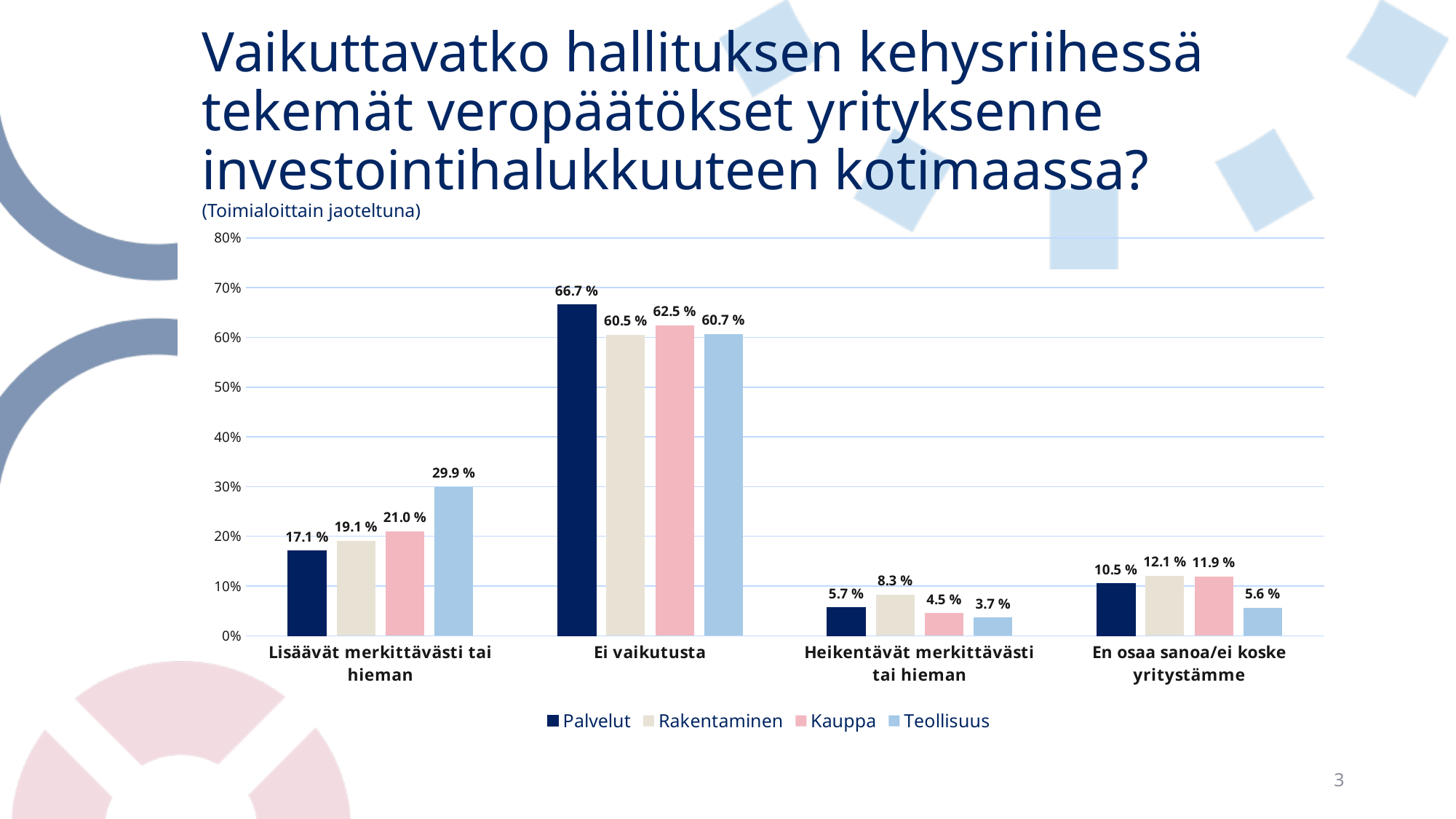
What kind of chart is shown on the slide? Bar chart Which series has the lowest value in the "Heikentävät merkittävästi tai hieman" category? Teollisuus What is the value for Palvelut in the "Ei vaikutusta" category? 66.7 % What is the value for Teollisuus in the "Lisäävät merkittävästi tai hieman" category? 29.9 % What is the value for Kauppa in the "Heikentävät merkittävästi tai hieman" category? 4.5 % How many categories are shown on the x axis? 4 How many series does the legend list? 4 In the "En osaa sanoa/ei koske yritystämme" category, which is larger: Palvelut or Teollisuus? Palvelut Which series has the highest value in the "Ei vaikutusta" category? Palvelut Is the value for Kauppa in the "Ei vaikutusta" category greater or less than 60%? greater What is the value for Rakentaminen in the "En osaa sanoa/ei koske yritystämme" category? 12.1 % What is the difference between the Teollisuus and Palvelut values in the "Lisäävät merkittävästi tai hieman" category? 12.8 %